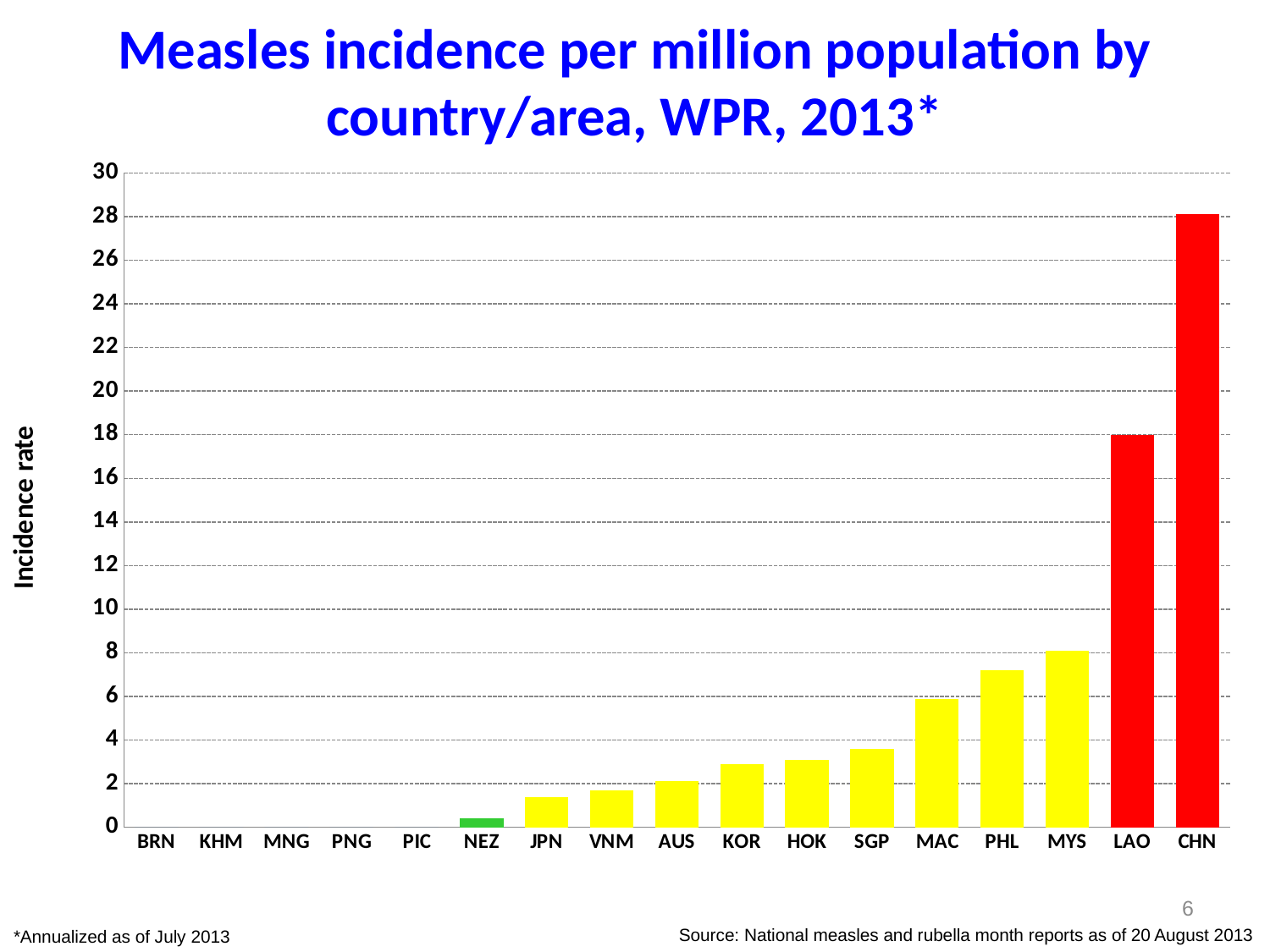
Is the incidence rate for MYS greater or less than 6? greater How many countries/areas are shown on the x axis of the chart? 17 Is the incidence rate for MAC greater or less than 10? less What is the label on the y axis of the chart? Incidence rate Is the incidence rate for CHN greater or less than 20? greater Which country/area has the highest measles incidence rate in the chart? CHN Which has a higher incidence rate, PHL or MAC? PHL Which has a higher incidence rate, LAO or MYS? LAO Do the incidence rates generally rise or fall moving from left to right along the x axis? rise What kind of chart is shown on the slide? bar chart